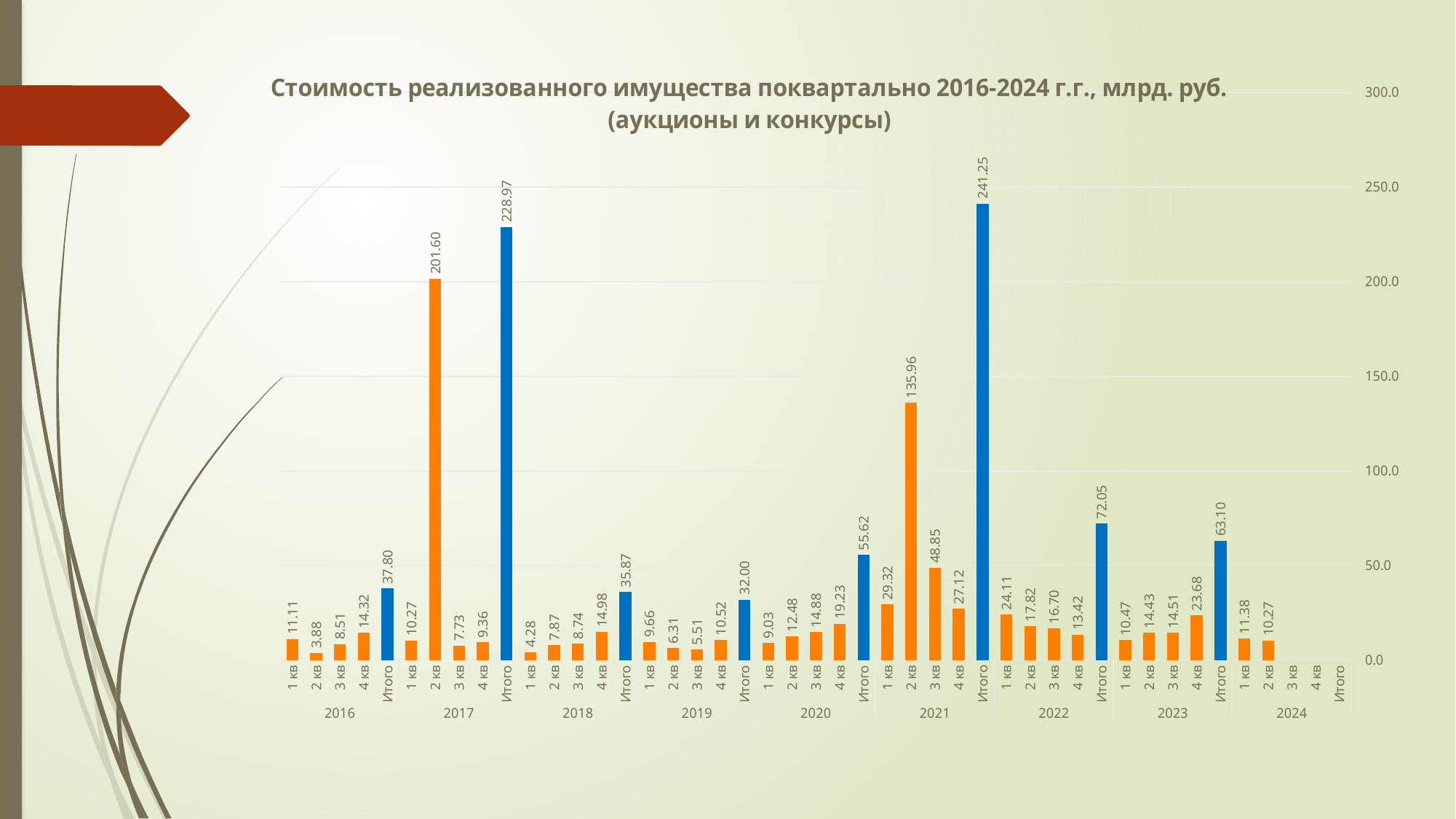
What colour are the Итого bars? blue How many years are shown on the x axis? 9 What is the value for 2 кв 2017? 201.60 What kind of chart is this? bar chart Which year has the highest Итого value? 2021 What is the Итого value for 2021? 241.25 What is the value for 4 кв 2023? 23.68 Which quarter of 2016 has the lowest value? 2 кв Which is larger, the Итого value for 2022 or for 2023? 2022 What is the difference between the Итого values for 2021 and 2017? 12.28 Is the value for 2 кв 2021 greater or less than 100.0? greater Do the quarterly values for 2022 rise or fall from 1 кв to 4 кв? fall